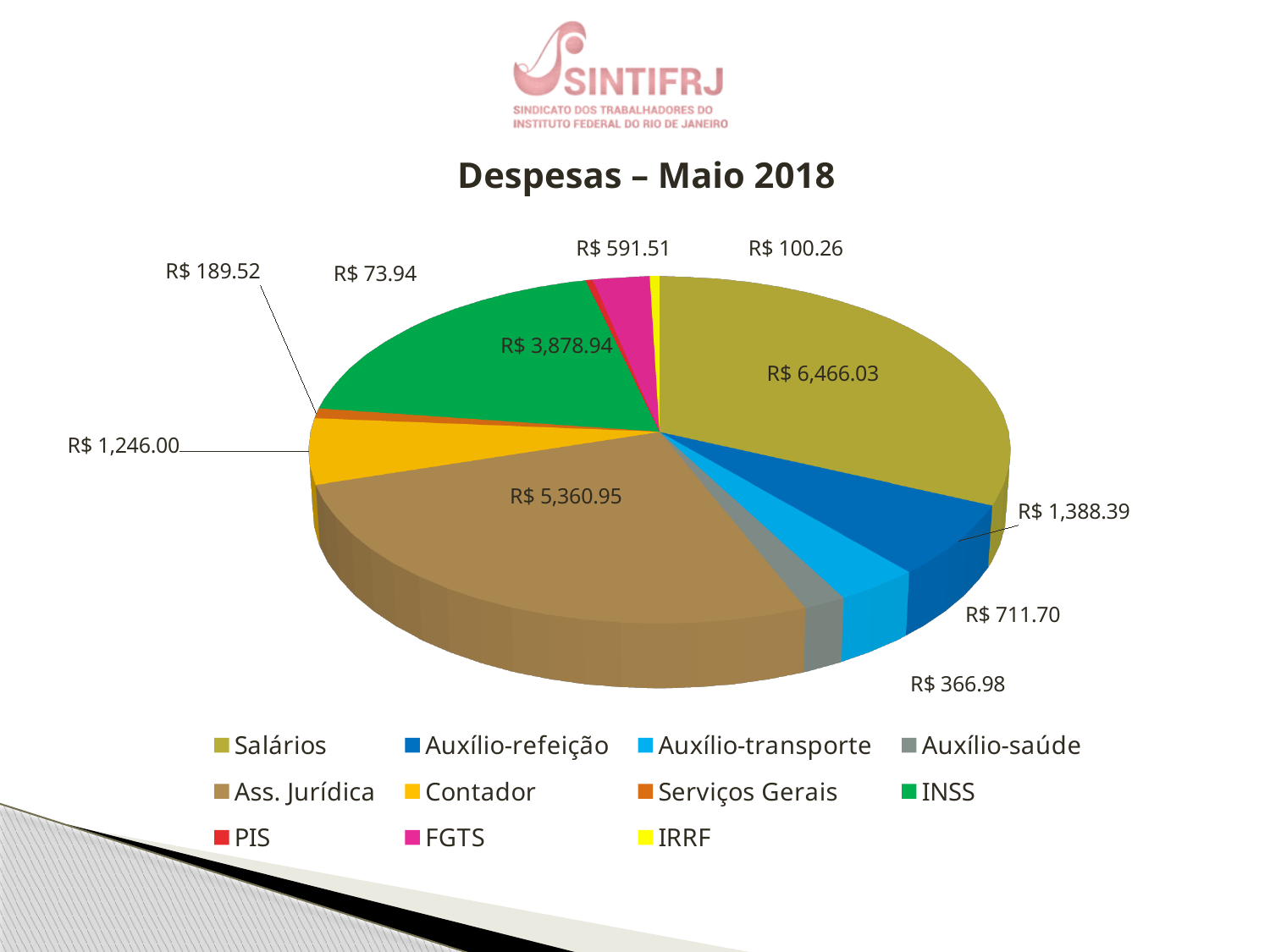
What is the value for Contador? R$ 1,246.00 What kind of chart is shown on the slide? Pie chart How many categories are shown in the pie chart? 11 What is the difference between Salários and Ass. Jurídica? R$ 1,105.08 What is the value for Ass. Jurídica? R$ 5,360.95 Which is larger, Auxílio-transporte or Auxílio-saúde? Auxílio-transporte What is the value for Auxílio-refeição? R$ 1,388.39 Which category has the smallest expense? PIS Which category has the largest expense? Salários What is the title of the chart? Despesas – Maio 2018 What is the value for INSS? R$ 3,878.94 What is the value for Salários? R$ 6,466.03